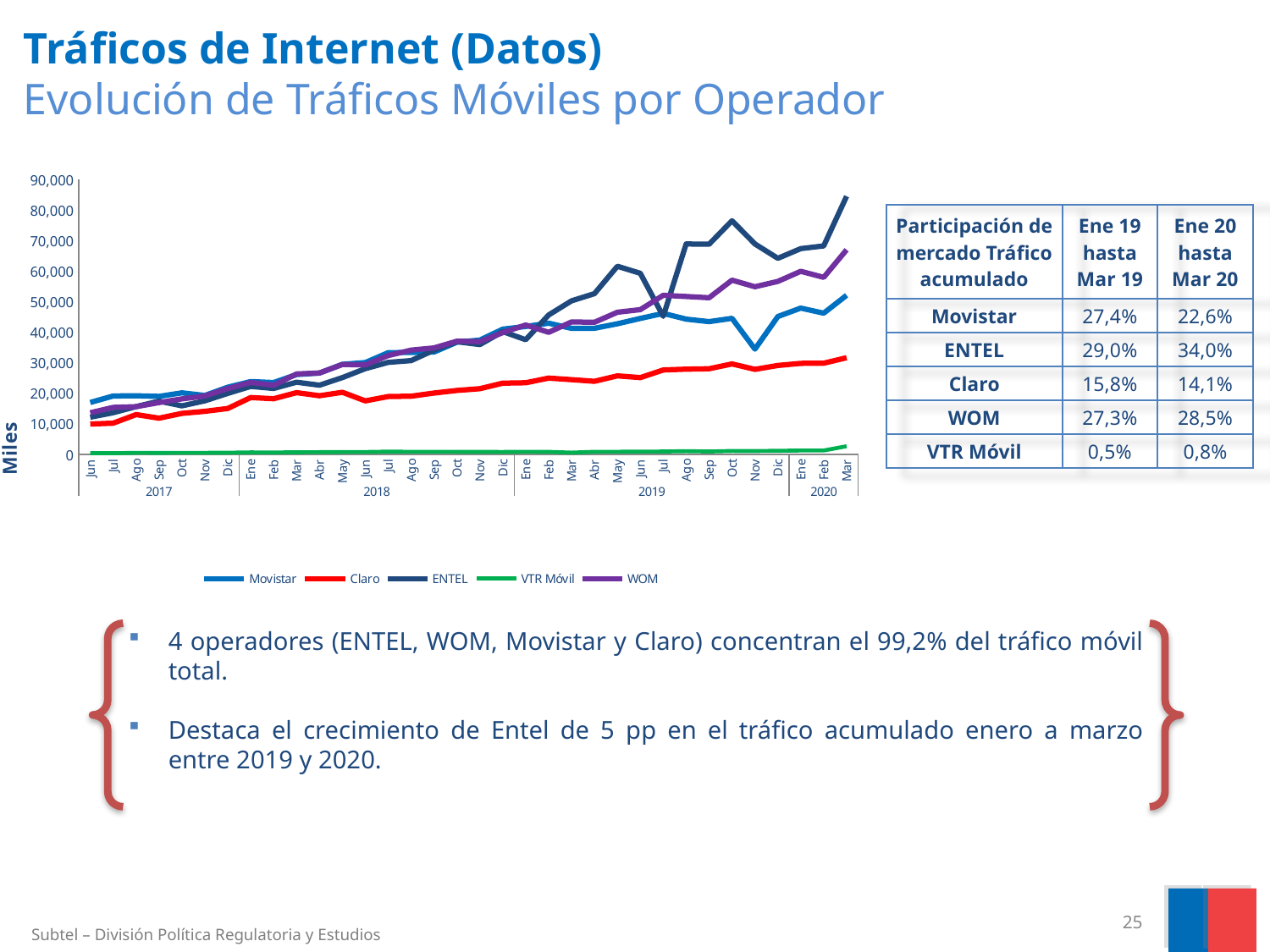
Is the value for Claro in Mar 2020 greater or less than 40,000? less Which operator has the highest traffic in Mar 2020 on the chart? ENTEL What kind of chart is shown on the slide? Line chart What colour is the Claro line in the chart legend? Red In Mar 2020, which is larger on the chart: WOM or Movistar? WOM Which operator has the lowest traffic throughout the chart? VTR Móvil How many monthly points are plotted along the x axis of the chart? 34 Is the value for WOM in Mar 2020 greater or less than 60,000? greater Does the ENTEL line generally rise or fall from Jun 2017 to Mar 2020? Rise Is the value for ENTEL in Mar 2020 greater or less than 80,000? greater How many series does the chart legend list? 5